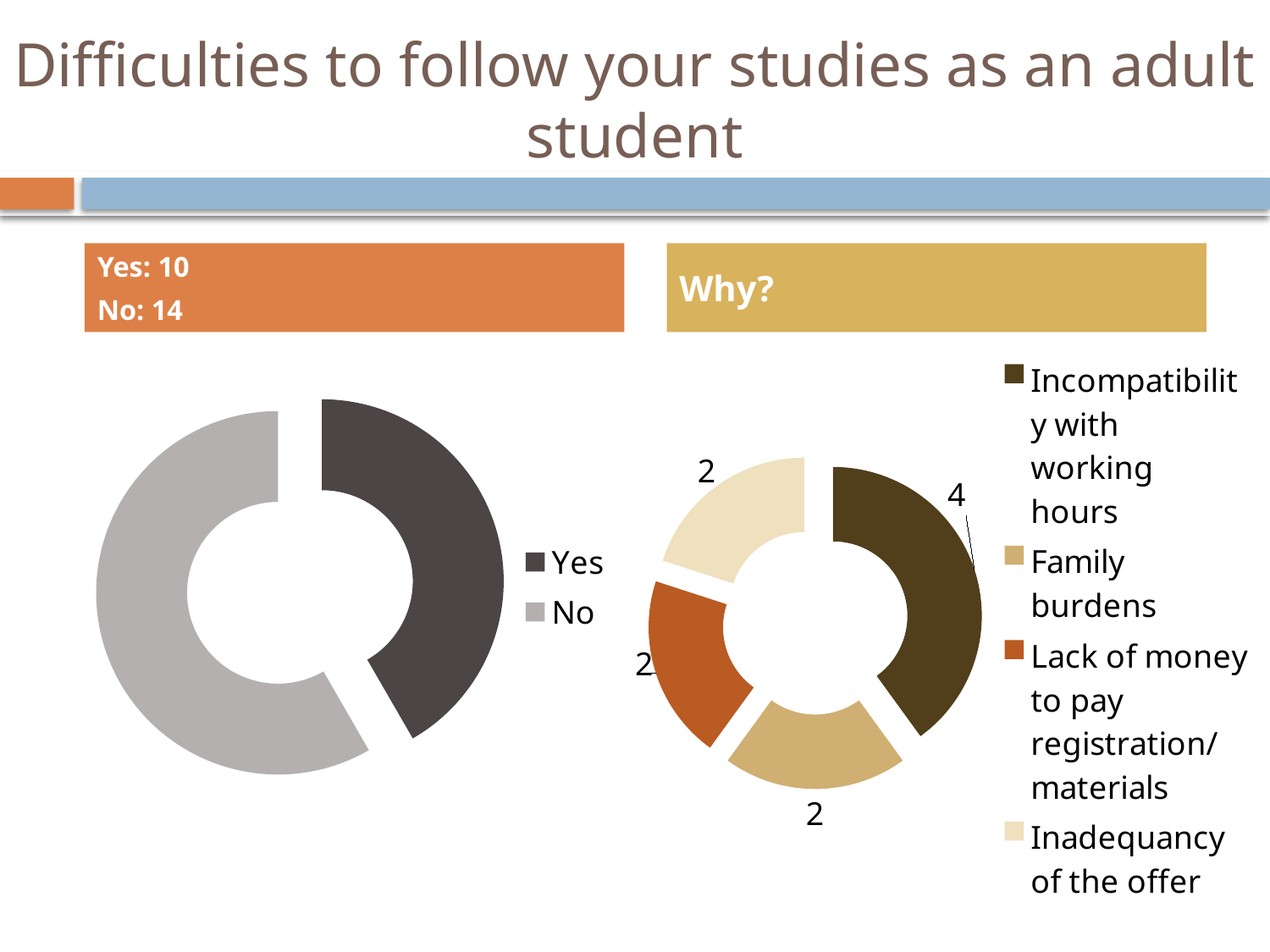
In the left chart, what is the value for Yes? 10 In the right chart (Why?), what share of the total does Incompatibility with working hours represent? 40% In the right chart (Why?), what is the total of all the values shown? 10 In the left chart, what colour represents No in the legend? Grey How many categories does the right chart (Why?) have? 4 In the left chart, which category is larger, Yes or No? No In the right chart (Why?), what is the difference between the value for Incompatibility with working hours and the value for Family burdens? 2 In the right chart (Why?), what is the value for Incompatibility with working hours? 4 How many categories does the left chart (Yes/No) have? 2 In the left chart, what is the value for No? 14 In the right chart (Why?), which category has the highest value? Incompatibility with working hours What kind of chart is the left chart showing Yes and No? Doughnut chart